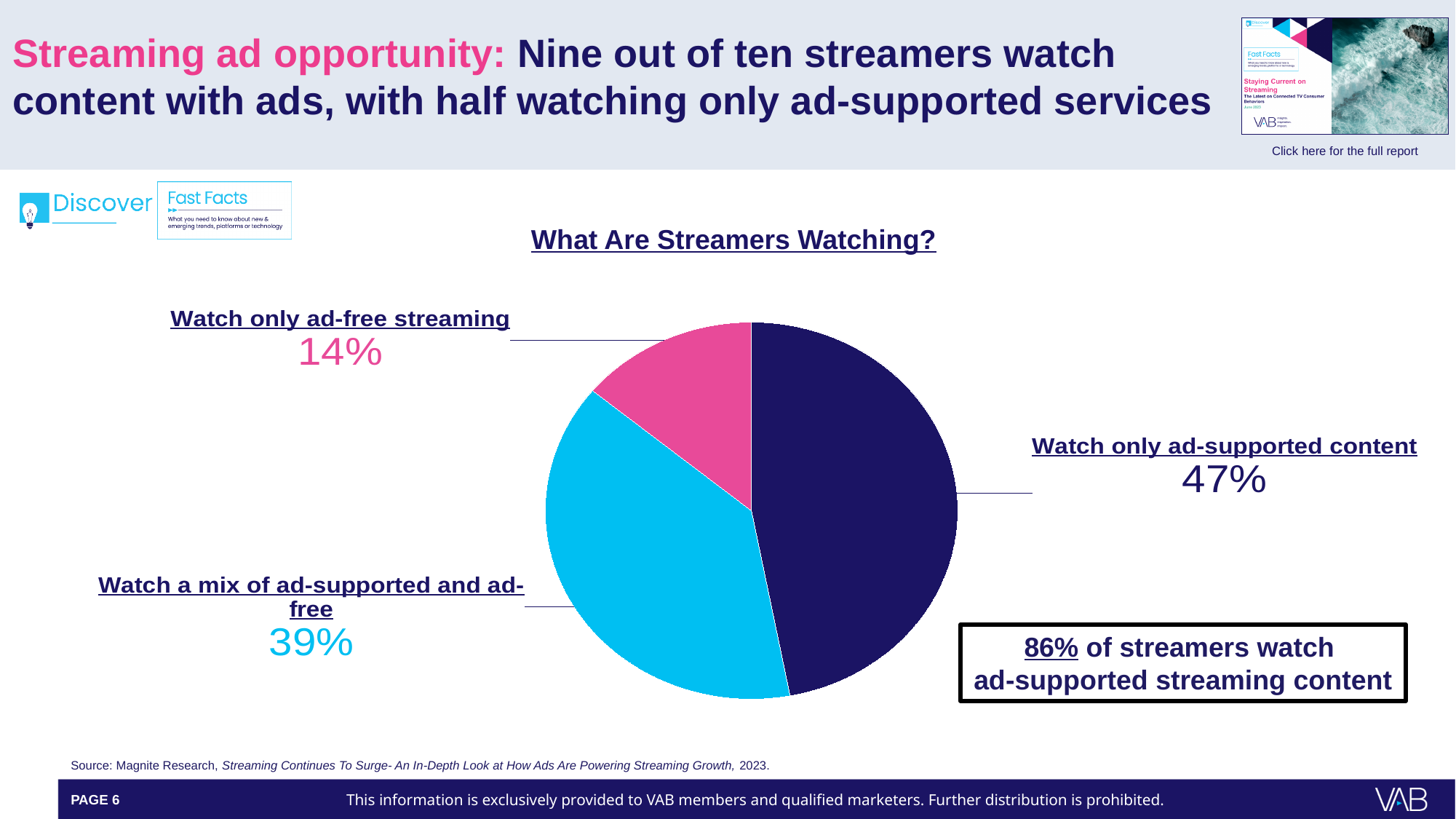
Which category has the smallest share of the pie? Watch only ad-free streaming Which is larger: the share that watch a mix of ad-supported and ad-free, or the share that watch only ad-free streaming? Watch a mix of ad-supported and ad-free What colour is the slice for 'Watch only ad-free streaming'? Pink What is the difference between the share that watch only ad-supported content and the share that watch only ad-free streaming? 33% What percentage of streamers watch only ad-free streaming? 14% What is the combined share of streamers who watch only ad-supported content and those who watch a mix of ad-supported and ad-free? 86% What percentage of streamers watch a mix of ad-supported and ad-free? 39% What is the title of the chart? What Are Streamers Watching? How many slices does the pie chart have? 3 What kind of chart is shown on the slide? Pie chart Which category has the largest share of the pie? Watch only ad-supported content What percentage of streamers watch only ad-supported content? 47%